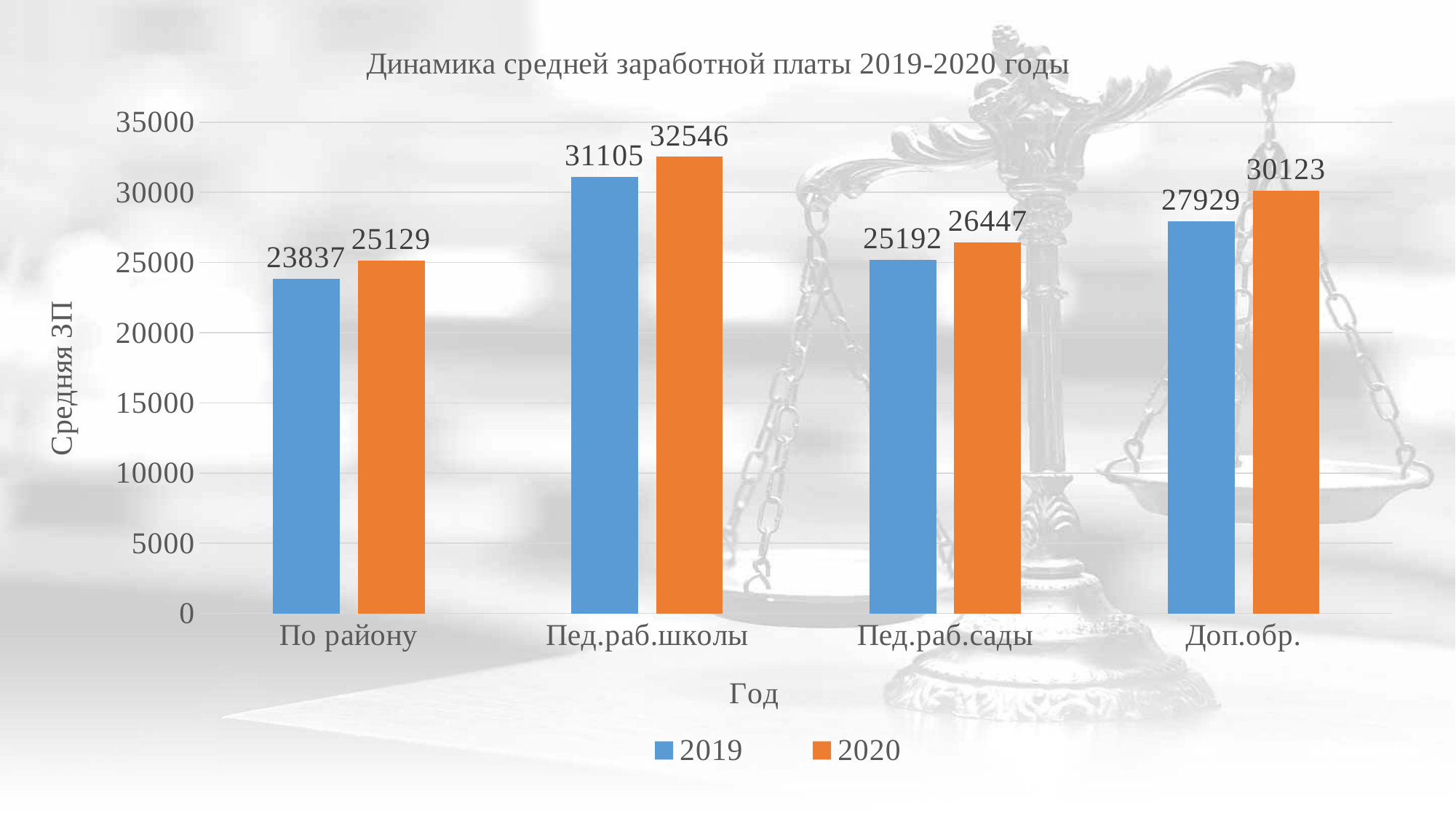
What is the difference between the 2020 and 2019 values for Доп.обр.? 2194 What is the 2020 value for Пед.раб.школы? 32546 What is the 2019 value for По району? 23837 Is the 2020 value for Доп.обр. greater or less than 30000? greater How many categories are shown on the x axis? 4 What is the difference between the 2020 and 2019 values for Пед.раб.сады? 1255 What is the 2019 value for Доп.обр.? 27929 Which is larger: the 2019 value for Пед.раб.сады or the 2020 value for По району? 2019 value for Пед.раб.сады What type of chart is shown? bar chart Which category has the highest 2020 value? Пед.раб.школы Which category has the lowest 2019 value? По району How many series does the legend list? 2